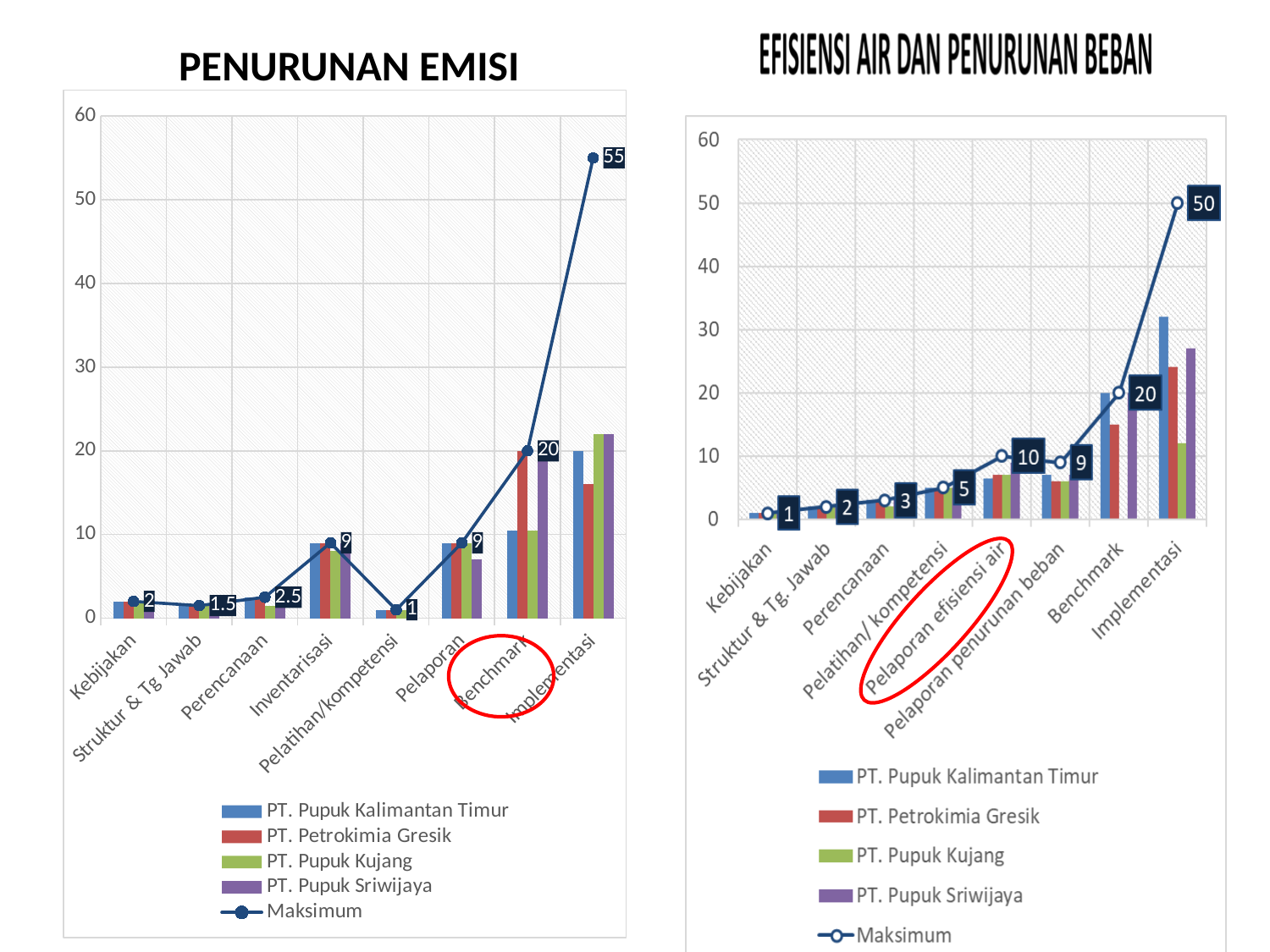
In the EFISIENSI AIR DAN PENURUNAN BEBAN chart, which has the larger Maksimum value: Pelaporan efisiensi air or Pelaporan penurunan beban? Pelaporan efisiensi air In the EFISIENSI AIR DAN PENURUNAN BEBAN chart, which category has the highest Maksimum value? Implementasi In the EFISIENSI AIR DAN PENURUNAN BEBAN chart, what is the Maksimum value for Implementasi? 50 In the EFISIENSI AIR DAN PENURUNAN BEBAN chart, how many categories are shown on the x axis? 8 In the PENURUNAN EMISI chart, what is the Maksimum value for Benchmark? 20 In the EFISIENSI AIR DAN PENURUNAN BEBAN chart, is the value for PT. Pupuk Kujang at Implementasi greater or less than 20? less In the PENURUNAN EMISI chart, what is the Maksimum value for Implementasi? 55 In the EFISIENSI AIR DAN PENURUNAN BEBAN chart, what is the Maksimum value for Pelaporan efisiensi air? 10 In the PENURUNAN EMISI chart, which category has the lowest Maksimum value? Pelatihan/kompetensi In the PENURUNAN EMISI chart, what is the difference between the Maksimum values for Implementasi and Benchmark? 35 In the PENURUNAN EMISI chart, what is the Maksimum value for Struktur & Tg Jawab? 1.5 In the PENURUNAN EMISI chart, how many series does the legend list? 5